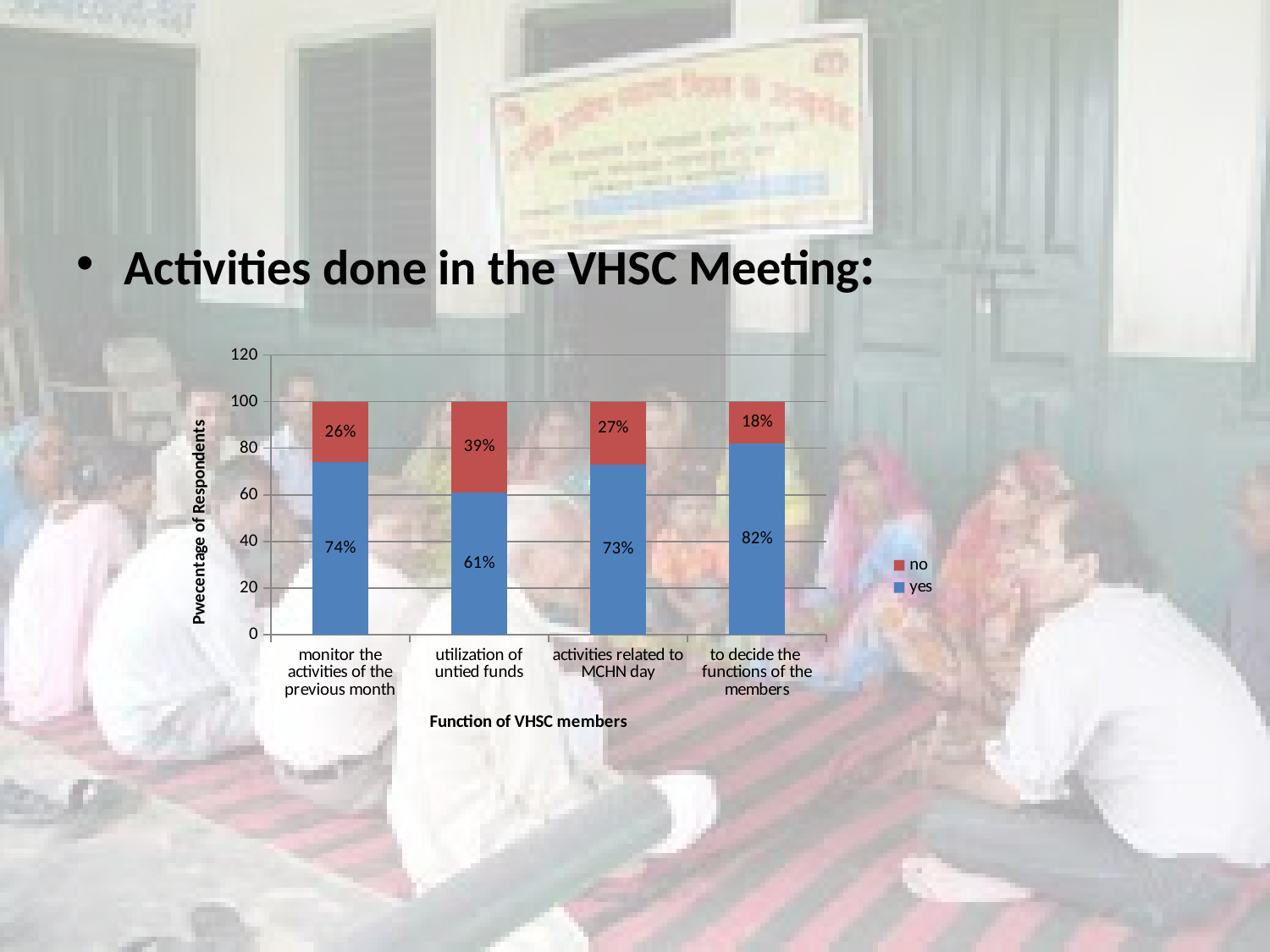
Which function has the highest "yes" percentage? to decide the functions of the members How many series does the chart legend list? 2 Is the "yes" value larger for "monitor the activities of the previous month" or for "utilization of untied funds"? monitor the activities of the previous month Which function has the highest "no" percentage? utilization of untied funds What is the "no" value for "monitor the activities of the previous month"? 26% What is the "yes" value for "activities related to MCHN day"? 73% What percentage of respondents answered "no" for "to decide the functions of the members"? 18% How many functions are shown on the x axis of the chart? 4 What percentage of respondents answered "yes" for "utilization of untied funds"? 61% What type of chart is shown on the slide? stacked bar chart What is the difference between the "yes" values for "to decide the functions of the members" and "utilization of untied funds"? 21% Which function has the lowest "yes" percentage? utilization of untied funds